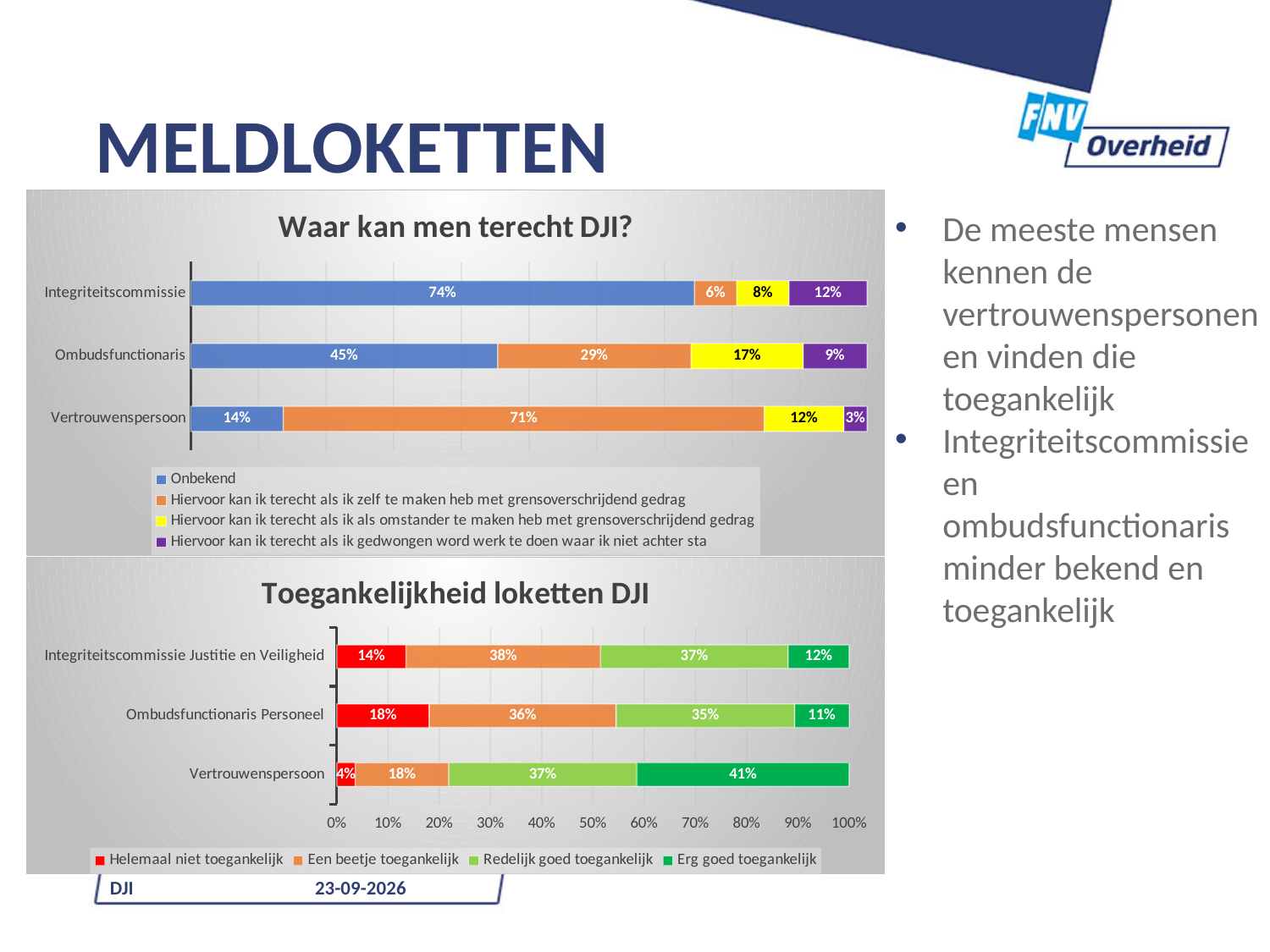
In the chart 'Waar kan men terecht DJI?', what is the difference between the 'Onbekend' values for Integriteitscommissie and Ombudsfunctionaris? 29% In the chart 'Waar kan men terecht DJI?', which category has the highest 'Onbekend' value? Integriteitscommissie In the chart 'Toegankelijkheid loketten DJI', which is larger: the 'Erg goed toegankelijk' value for Vertrouwenspersoon or for Integriteitscommissie Justitie en Veiligheid? Vertrouwenspersoon In the chart 'Waar kan men terecht DJI?', how many categories are shown? 3 In the chart 'Toegankelijkheid loketten DJI', what is the 'Helemaal niet toegankelijk' value for Ombudsfunctionaris Personeel? 18% In the chart 'Waar kan men terecht DJI?', what is the 'Onbekend' value for Integriteitscommissie? 74% In the chart 'Waar kan men terecht DJI?', how many series does the legend list? 4 In the chart 'Toegankelijkheid loketten DJI', what is the 'Erg goed toegankelijk' value for Vertrouwenspersoon? 41% In the chart 'Waar kan men terecht DJI?', what is the 'Onbekend' value for Vertrouwenspersoon? 14% What kind of chart is 'Toegankelijkheid loketten DJI'? Stacked bar chart In the chart 'Toegankelijkheid loketten DJI', which category has the lowest 'Helemaal niet toegankelijk' value? Vertrouwenspersoon In the chart 'Toegankelijkheid loketten DJI', what colour represents 'Helemaal niet toegankelijk'? Red